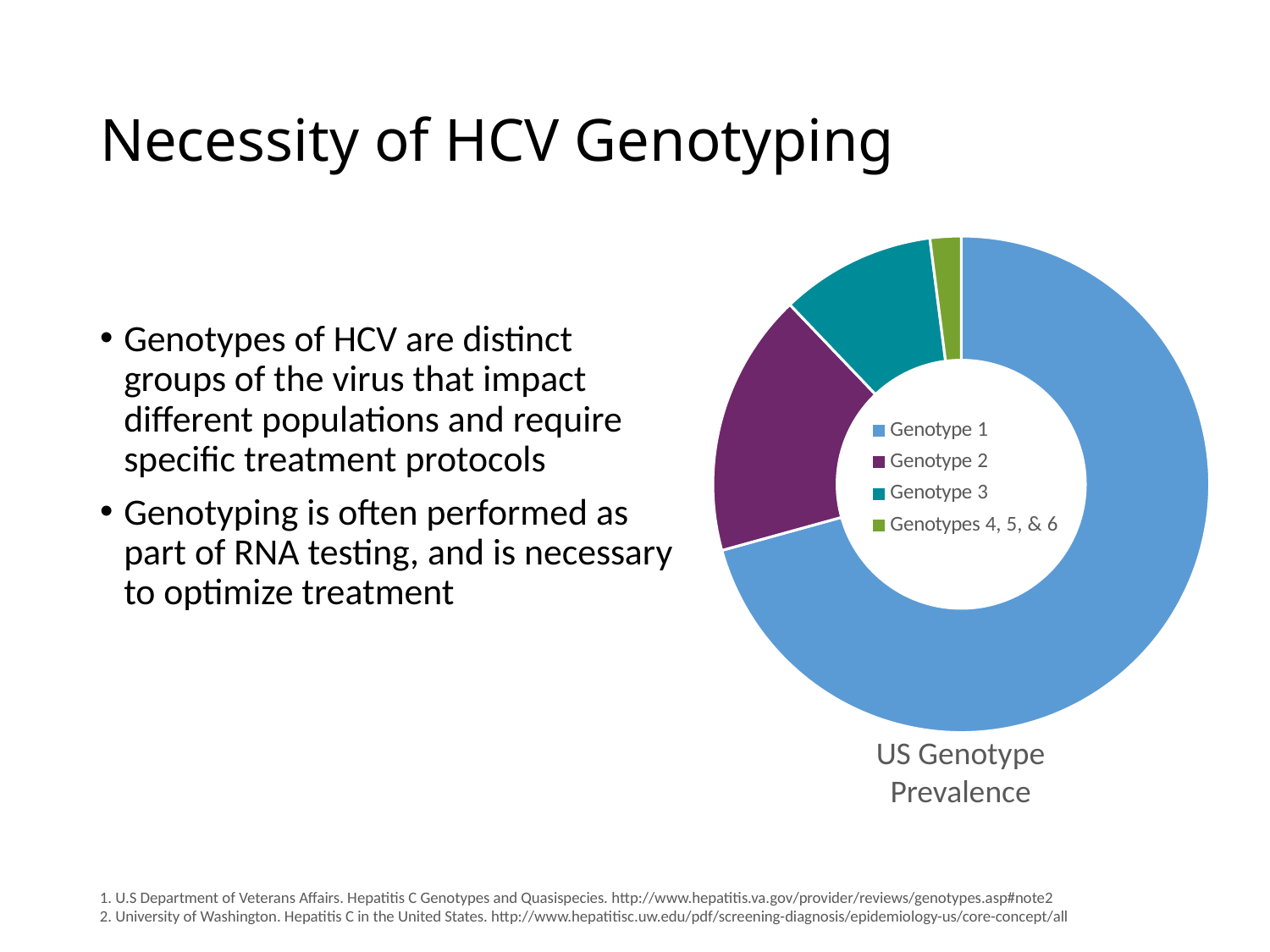
Is Genotype 1's share of the chart greater or less than 50%? greater What kind of chart is shown on the slide? Doughnut (pie) chart How many entries does the chart's legend list? 4 Which genotype category has the smallest share of the chart? Genotypes 4, 5, & 6 Which genotype category has the largest share of the chart? Genotype 1 What colour represents Genotype 2 in the chart? Purple Which has a larger share of the chart, Genotype 3 or Genotypes 4, 5, & 6? Genotype 3 What is the title of the chart? US Genotype Prevalence Which has a larger share of the chart, Genotype 2 or Genotype 3? Genotype 2 What is the last entry listed in the chart's legend? Genotypes 4, 5, & 6 How many categories does the chart show? 4 Which has a larger share of the chart, Genotype 1 or Genotype 2? Genotype 1